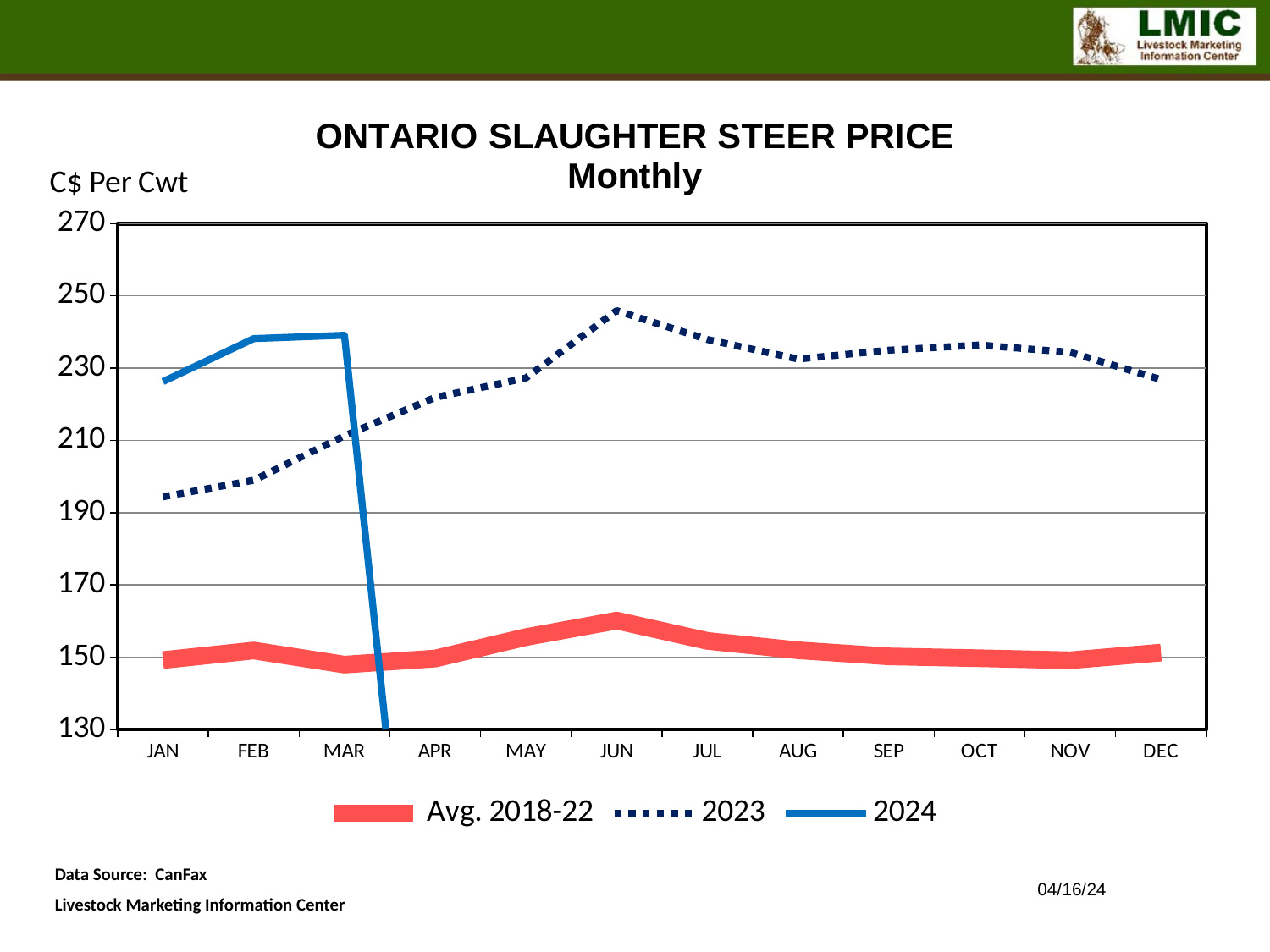
Is the 2024 value for FEB greater or less than 230? greater In FEB, which series has the higher value, 2024 or 2023? 2024 How many months are shown along the x axis? 12 Is the 2023 value for JAN greater or less than 210? less Does the 2023 series rise or fall from JAN to JUN? rise In which month does the 2023 series reach its highest value? JUN What kind of chart is shown on the slide? line chart How many series does the legend list? 3 In which month is the 2023 series at its lowest value? JAN Is the Avg. 2018-22 value for JUN greater or less than 170? less In which month does the Avg. 2018-22 series reach its highest value? JUN